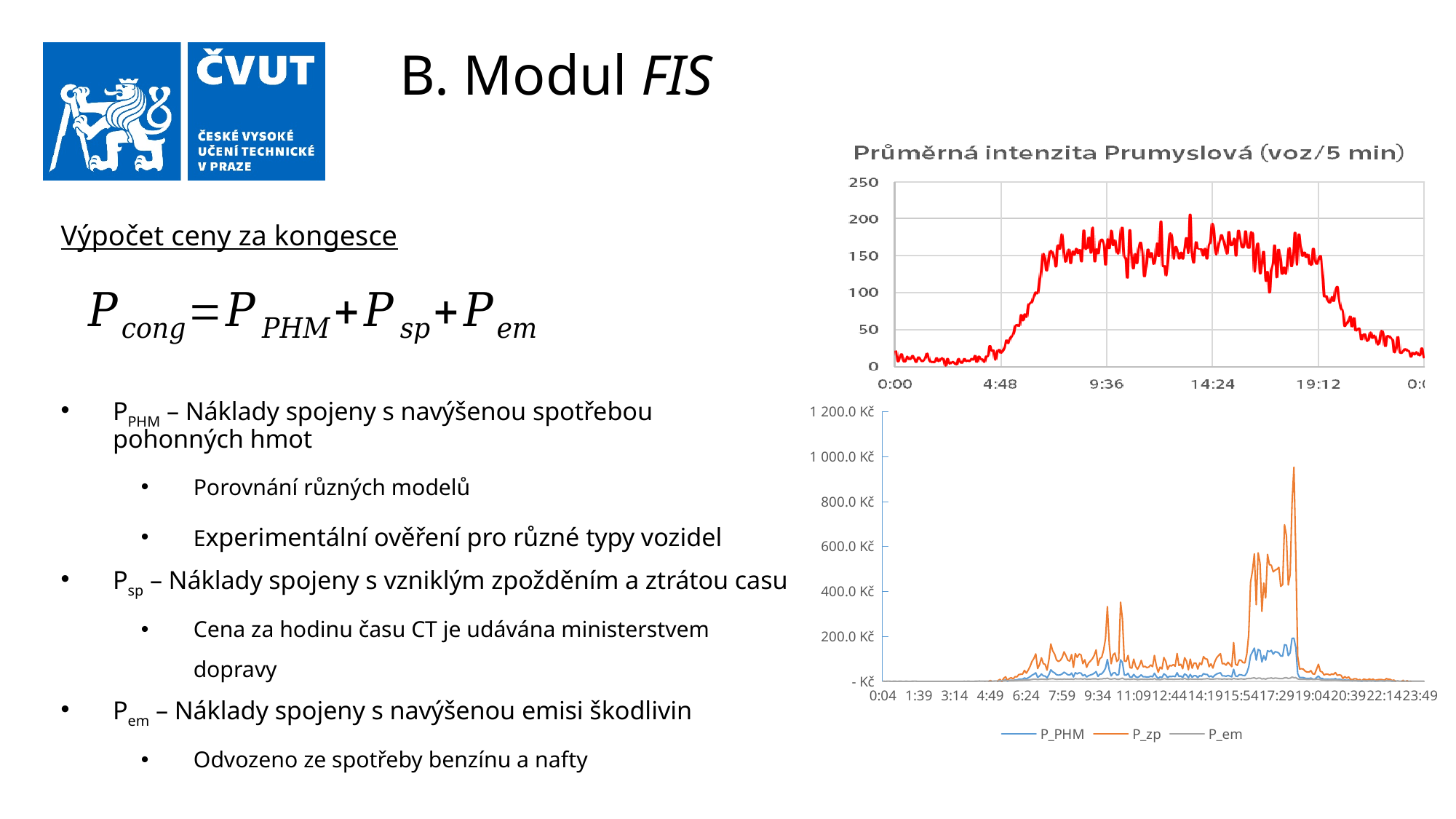
What type of chart is the bottom chart with the legend P_PHM, P_zp, P_em? line chart What is the title of the top chart? Průměrná intenzita Prumyslová (voz/5 min) How many series does the legend of the bottom chart list? 3 In the top chart, is the value at 0:00 greater or less than 50? less In the top chart, is the value at 14:24 greater or less than 100? greater In the bottom chart, is the peak value of P_zp greater or less than 800.0 Kč? greater In the bottom chart, which series stays lowest throughout the day? P_em What type of chart is the top chart titled "Průměrná intenzita Prumyslová (voz/5 min)"? line chart In the bottom chart, which series reaches the highest peak value? P_zp What are the series names in the legend of the bottom chart? P_PHM, P_zp, P_em